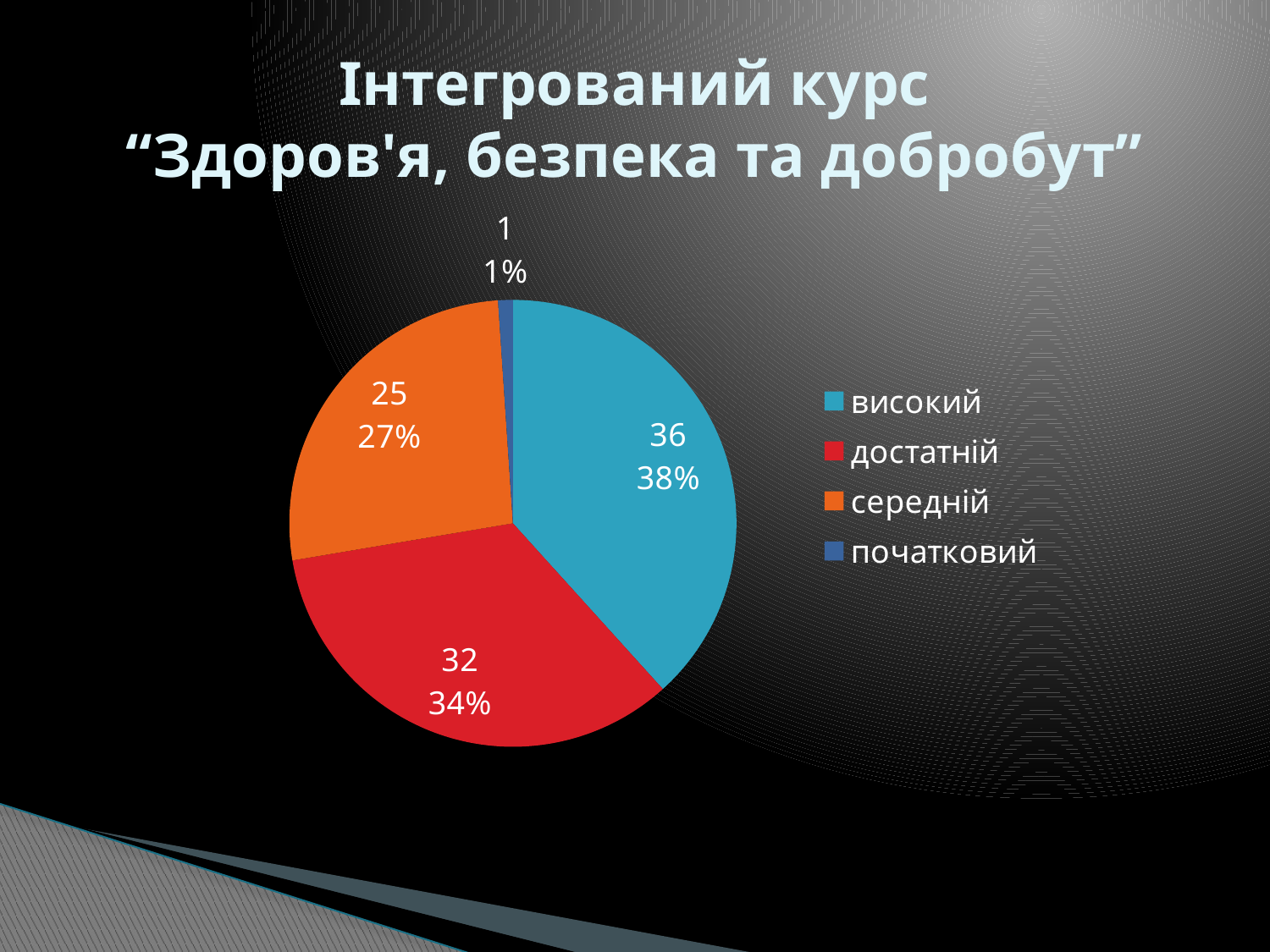
Which category has the smallest slice? початковий Which category has the largest slice? високий What share of the pie does достатній take? 34% What kind of chart is shown on the slide? pie chart What is the value for достатній? 32 How many categories does the legend list? 4 Which is larger, the value for достатній or the value for середній? достатній What is the value for середній? 25 What is the value for початковий? 1 What share of the pie does середній take? 27% What is the difference between the values for високий and середній? 11 What is the value for високий? 36